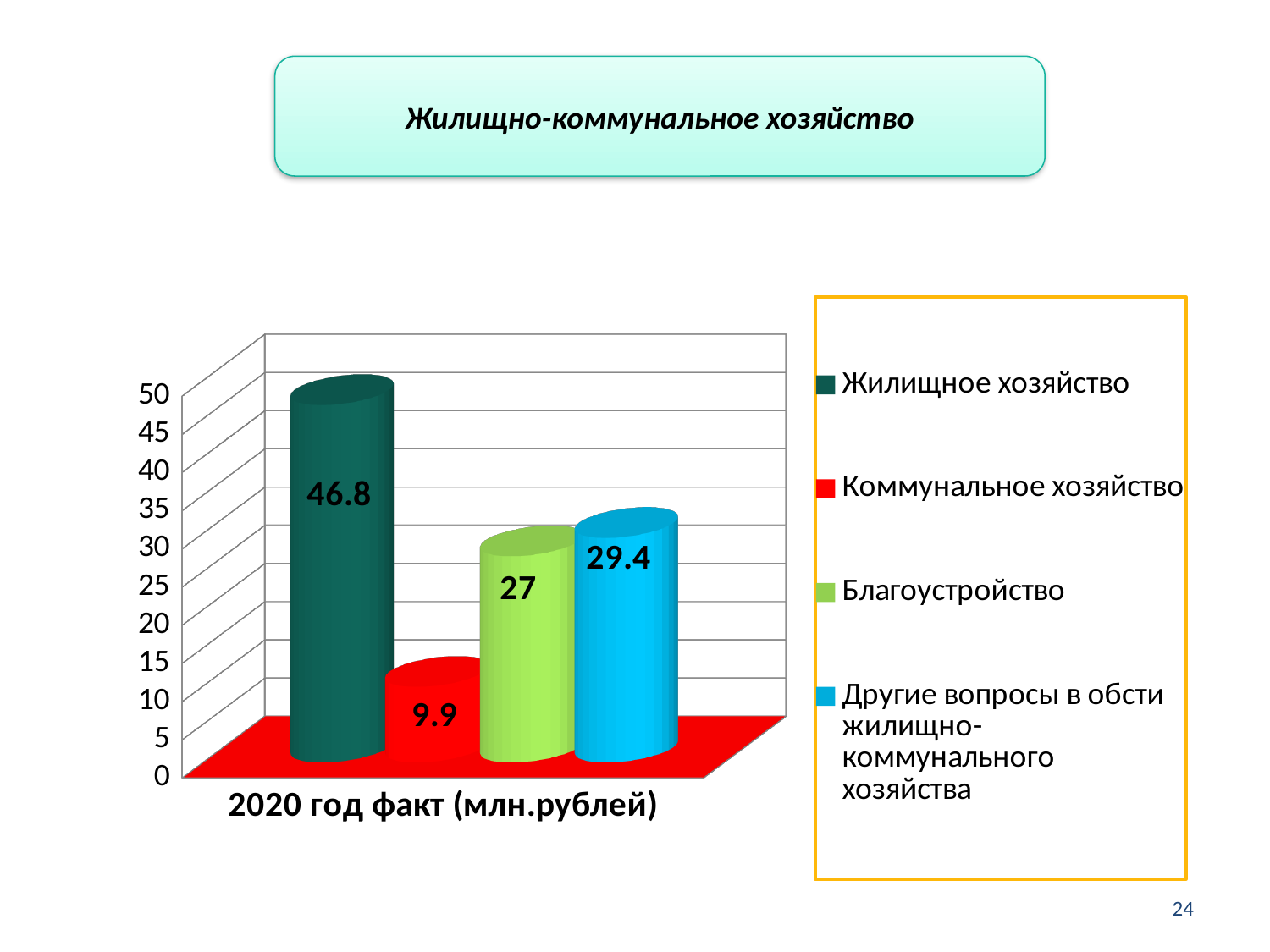
What is the label of the category on the x axis of the chart? 2020 год факт (млн.рублей) Which is larger, the value for Благоустройство or the value for Другие вопросы в обсти жилищно-коммунального хозяйства? Другие вопросы в обсти жилищно-коммунального хозяйства What is the value for Жилищное хозяйство in 2020 год факт (млн.рублей)? 46.8 What is the difference between the values for Другие вопросы в обсти жилищно-коммунального хозяйства and Благоустройство? 2.4 What kind of chart is shown on the slide? Bar chart Which series has the highest value on the chart? Жилищное хозяйство What is the value for Благоустройство in 2020 год факт (млн.рублей)? 27 What is the difference between the values for Жилищное хозяйство and Коммунальное хозяйство? 36.9 Which series has the lowest value on the chart? Коммунальное хозяйство What is the value for Коммунальное хозяйство in 2020 год факт (млн.рублей)? 9.9 What is the value for Другие вопросы в обсти жилищно-коммунального хозяйства in 2020 год факт (млн.рублей)? 29.4 How many series does the legend list? 4